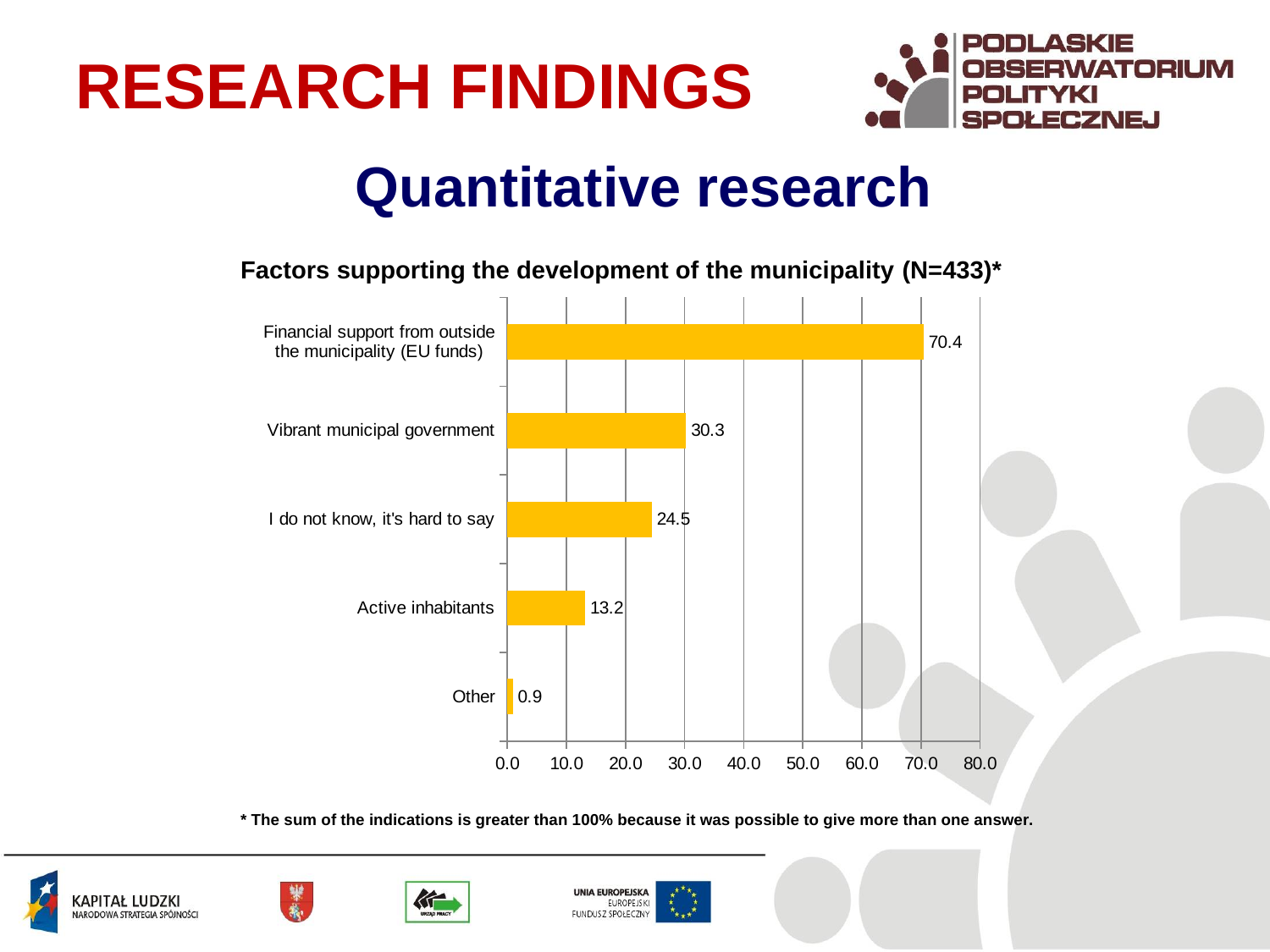
What is the difference between the values for 'Vibrant municipal government' and 'I do not know, it's hard to say'? 5.8 What kind of chart is shown on the slide? Bar chart Which category has the lowest value? Other What is the value for 'Vibrant municipal government'? 30.3 Which is larger: the value for 'Active inhabitants' or the value for 'I do not know, it's hard to say'? I do not know, it's hard to say What is the value for 'Financial support from outside the municipality (EU funds)'? 70.4 What is the value for 'Active inhabitants'? 13.2 Which category has the highest value? Financial support from outside the municipality (EU funds) What is the title of the chart? Factors supporting the development of the municipality (N=433)* What is the value for 'Other'? 0.9 How many categories are shown in the chart? 5 Is the value for 'Financial support from outside the municipality (EU funds)' greater or less than 60.0? greater